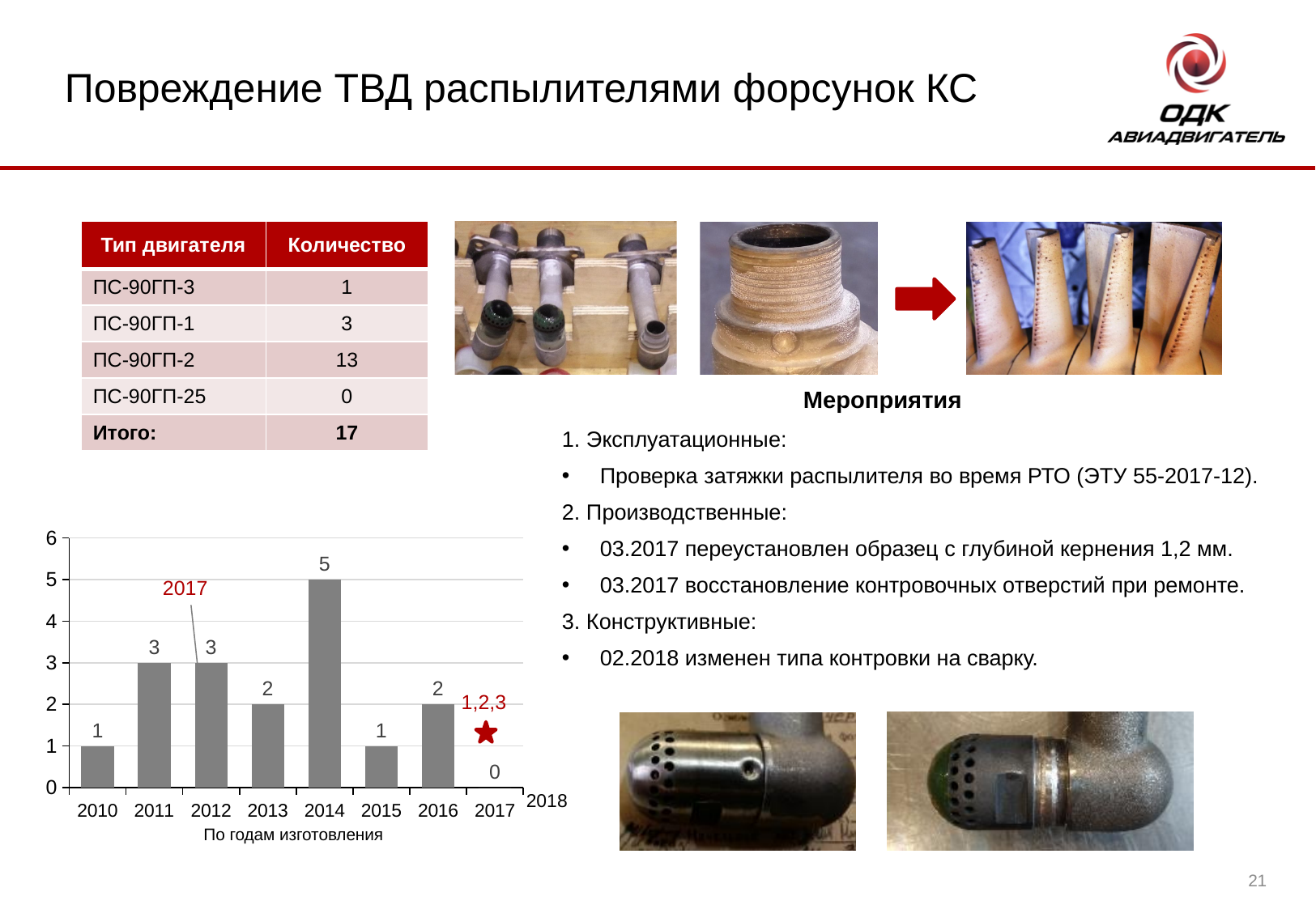
Do the values in the bar chart rise or fall from 2014 to 2015? fall What is the value for 2016 in the bar chart? 2 What is the value for 2017 in the bar chart? 0 What is the value for 2010 in the bar chart? 1 What is the value for 2014 in the bar chart? 5 Which year has the highest value in the bar chart? 2014 Which is larger in the bar chart, the value for 2011 or the value for 2015? 2011 What is the difference between the values for 2014 and 2013 in the bar chart? 3 What is the x-axis title of the bar chart? По годам изготовления Which year has the lowest value in the bar chart? 2017 What kind of chart is shown on the slide? bar chart Is the value for 2014 in the bar chart greater or less than 4? greater